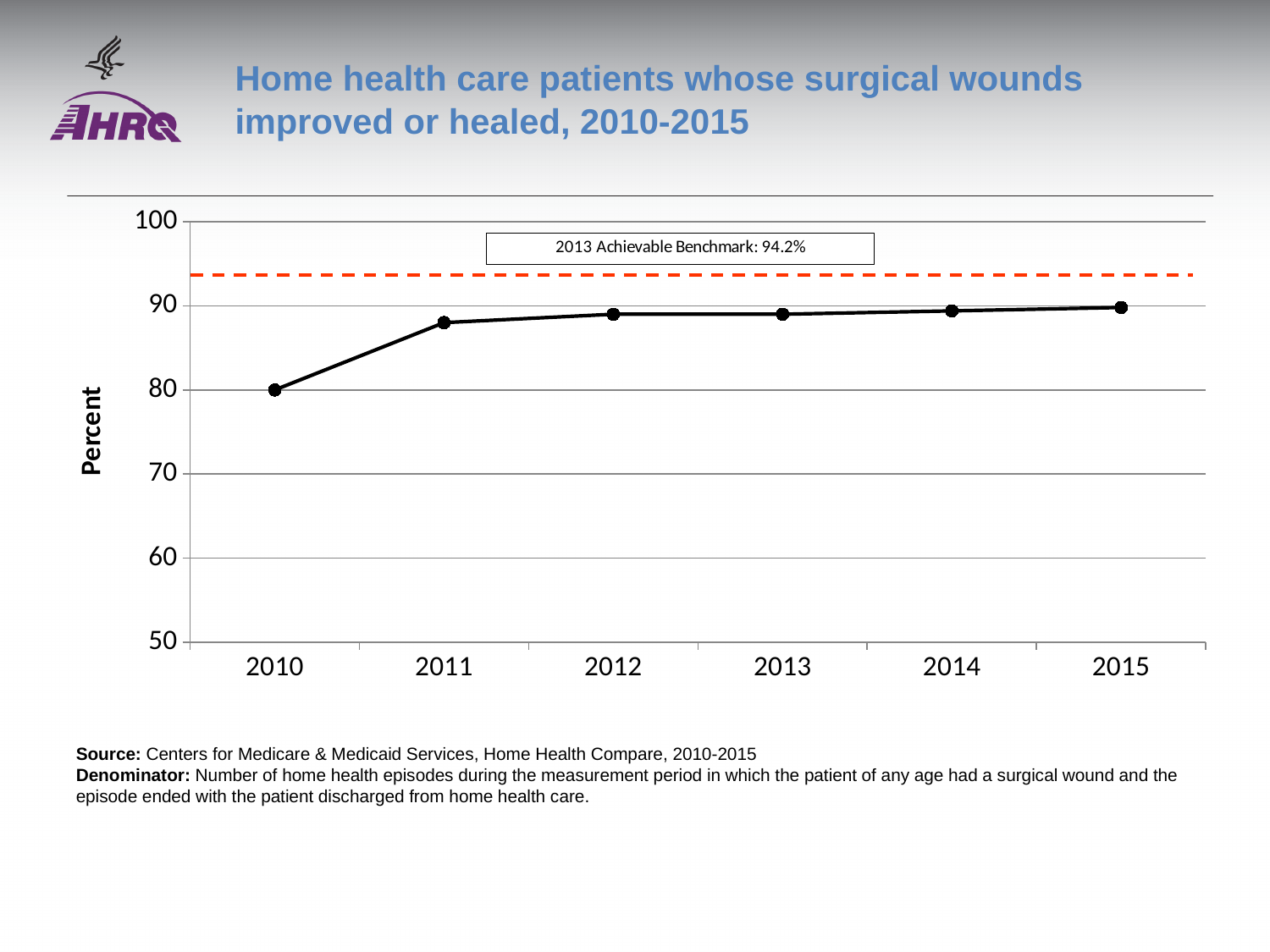
Do the plotted values rise or fall from 2010 to 2015? rise Which year has the lowest value? 2010 What is the label on the y axis? Percent What kind of chart is shown on the slide? line chart What is the 2013 achievable benchmark shown on the chart? 94.2% Is the value for 2011 greater or less than 90? less Is the value for 2013 greater or less than 80? greater Is the value for 2010 greater or less than 90? less How many years are plotted on the x axis? 6 Is the value for 2015 greater or less than the 2013 achievable benchmark of 94.2%? less Which year has the larger value, 2010 or 2011? 2011